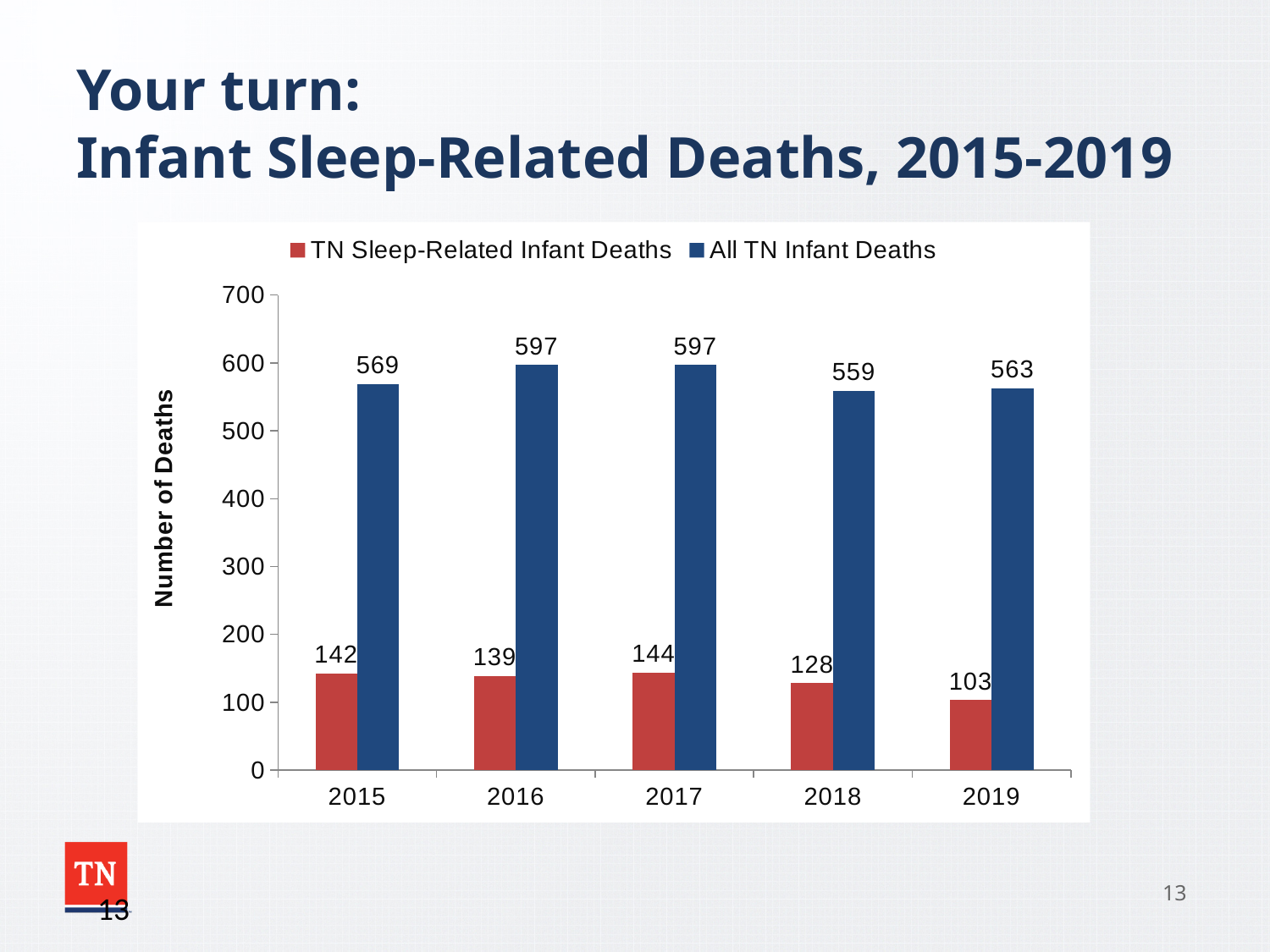
Which is larger: All TN Infant Deaths in 2015 or in 2019? 2015 What is the value for All TN Infant Deaths in 2018? 559 What is the label of the y axis? Number of Deaths What is the difference between TN Sleep-Related Infant Deaths in 2018 and 2019? 25 What is the value for TN Sleep-Related Infant Deaths in 2019? 103 How many years are shown on the x axis? 5 Which year has the lowest value for TN Sleep-Related Infant Deaths? 2019 Which year has the lowest value for All TN Infant Deaths? 2018 What is the difference between All TN Infant Deaths and TN Sleep-Related Infant Deaths in 2015? 427 What kind of chart is shown on the slide? Bar chart What is the value for TN Sleep-Related Infant Deaths in 2017? 144 How many series does the legend list? 2